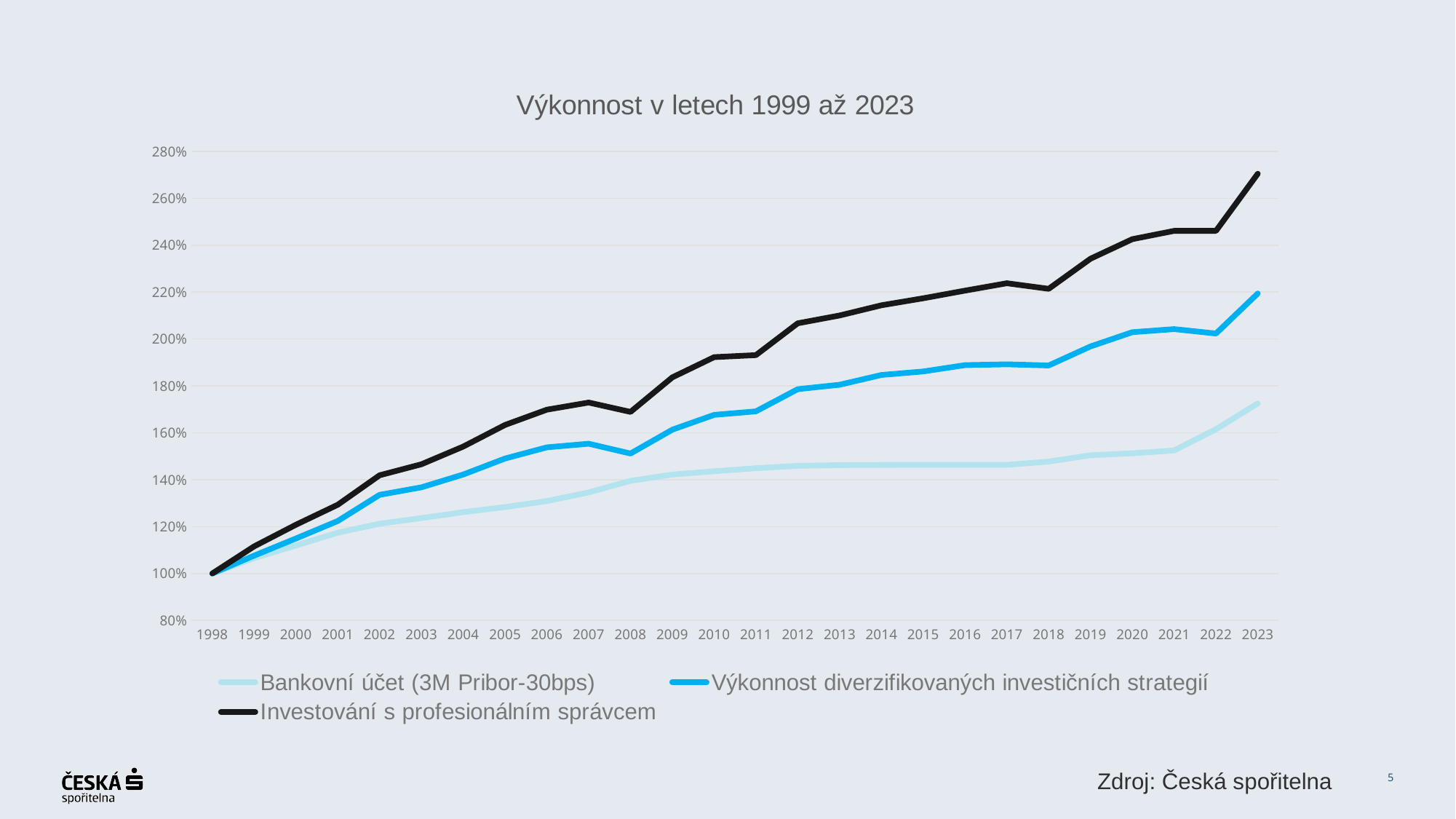
What is the value of all three series in 1998? 100% In 2023, which is larger: Bankovní účet (3M Pribor-30bps) or Výkonnost diverzifikovaných investičních strategií? Výkonnost diverzifikovaných investičních strategií Is the value for Investování s profesionálním správcem in 2008 greater or less than 180%? less Is the value for Výkonnost diverzifikovaných investičních strategií in 2016 greater or less than 200%? less Is the value for Bankovní účet (3M Pribor-30bps) in 2023 greater or less than 160%? greater What is the title of the chart? Výkonnost v letech 1999 až 2023 What kind of chart is shown on the slide? line chart How many series does the legend list? 3 How many years are plotted along the x axis? 26 Which series has the highest value in 2023? Investování s profesionálním správcem Which series has the lowest value in 2023? Bankovní účet (3M Pribor-30bps)